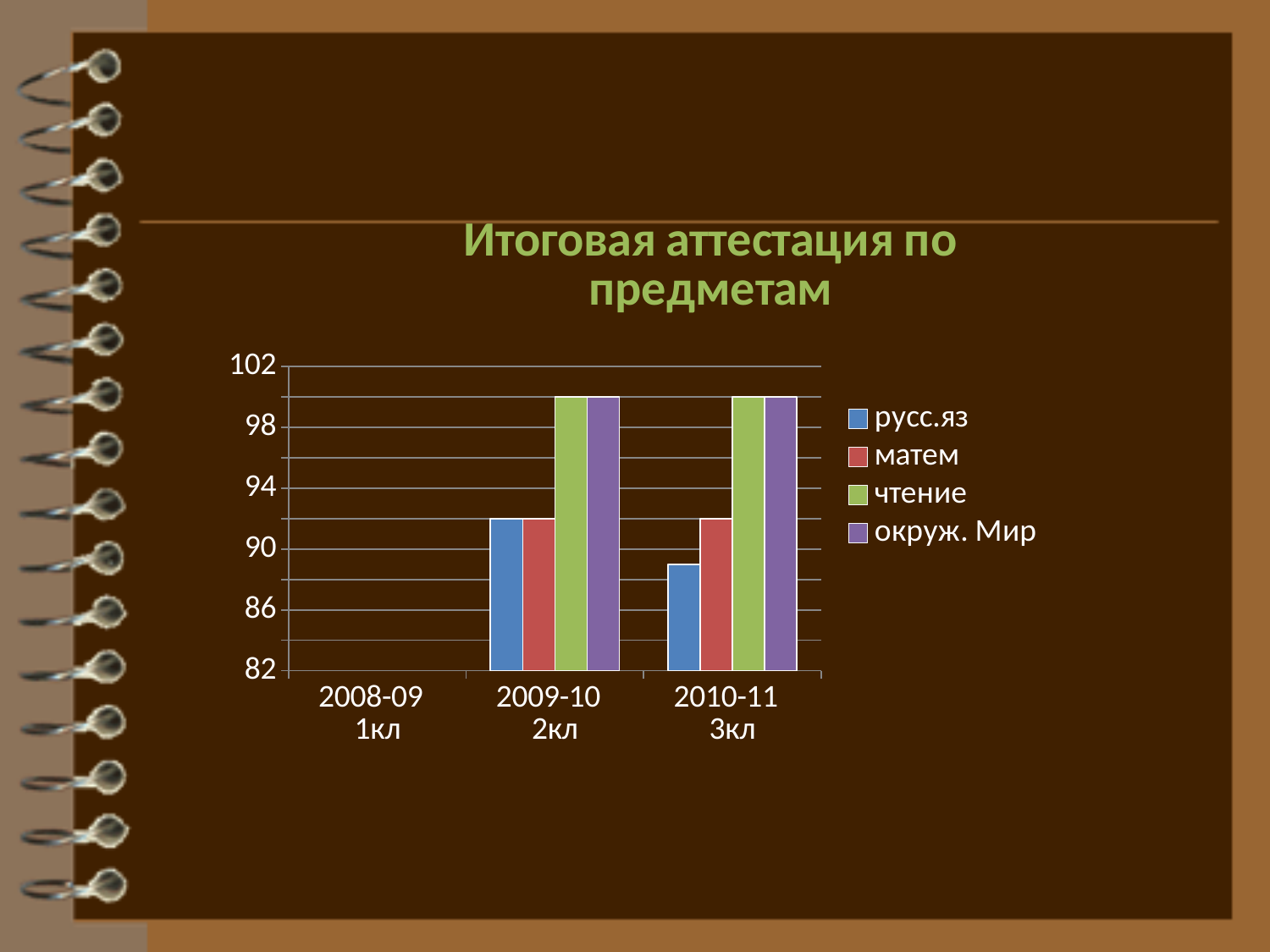
Which subject has the lowest value in 2010-11 3кл? русс.яз Is the value for матем in 2010-11 3кл greater or less than 90? greater Which category on the x axis has no bars plotted? 2008-09 1кл Does the value for русс.яз rise or fall from 2009-10 2кл to 2010-11 3кл? fall What is the title of the chart? Итоговая аттестация по предметам Is the value for чтение in 2009-10 2кл greater or less than 98? greater Is the value for русс.яз in 2010-11 3кл greater or less than 90? less In 2010-11 3кл, which is larger: русс.яз or матем? матем How many series does the legend list? 4 How many categories are shown on the x axis? 3 What kind of chart is shown on the slide? bar chart In 2009-10 2кл, which is larger: русс.яз or чтение? чтение